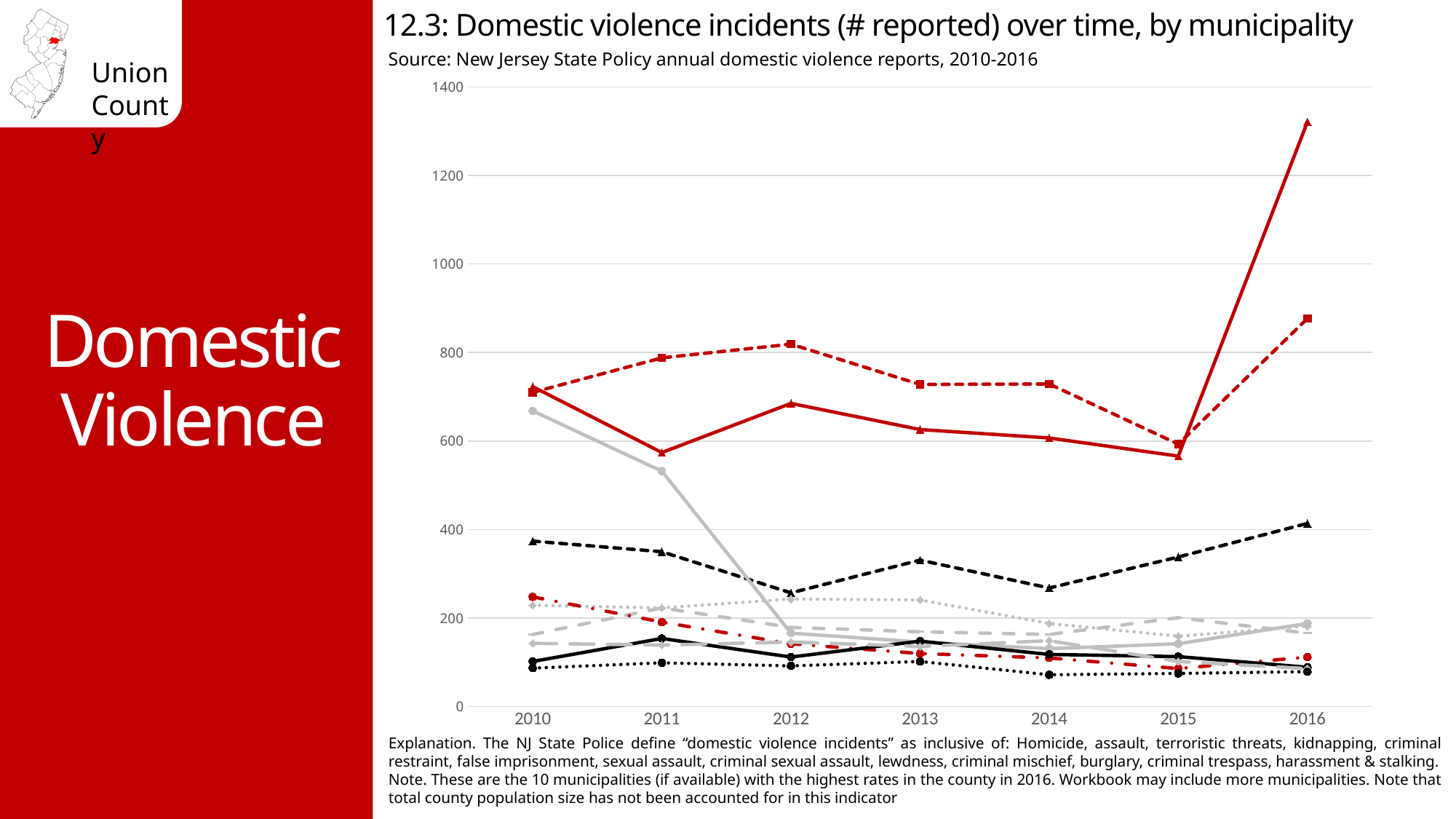
Does the solid red line with triangle markers rise or fall between 2015 and 2016? rise What kind of chart is shown on the slide? line chart Is the 2010 value of the solid gray line greater or less than 600? greater Is the 2016 value of the dashed red line with square markers greater or less than 800? greater Is the 2012 value of the solid gray line greater or less than 400? less What is the highest value shown on the y axis of the chart? 1400 What is the title of the chart? 12.3: Domestic violence incidents (# reported) over time, by municipality How many years are shown along the x axis of the chart? 7 Does the solid gray line rise or fall between 2010 and 2012? fall In 2016, which is higher: the solid red line with triangle markers or the dashed red line with square markers? the solid red line with triangle markers